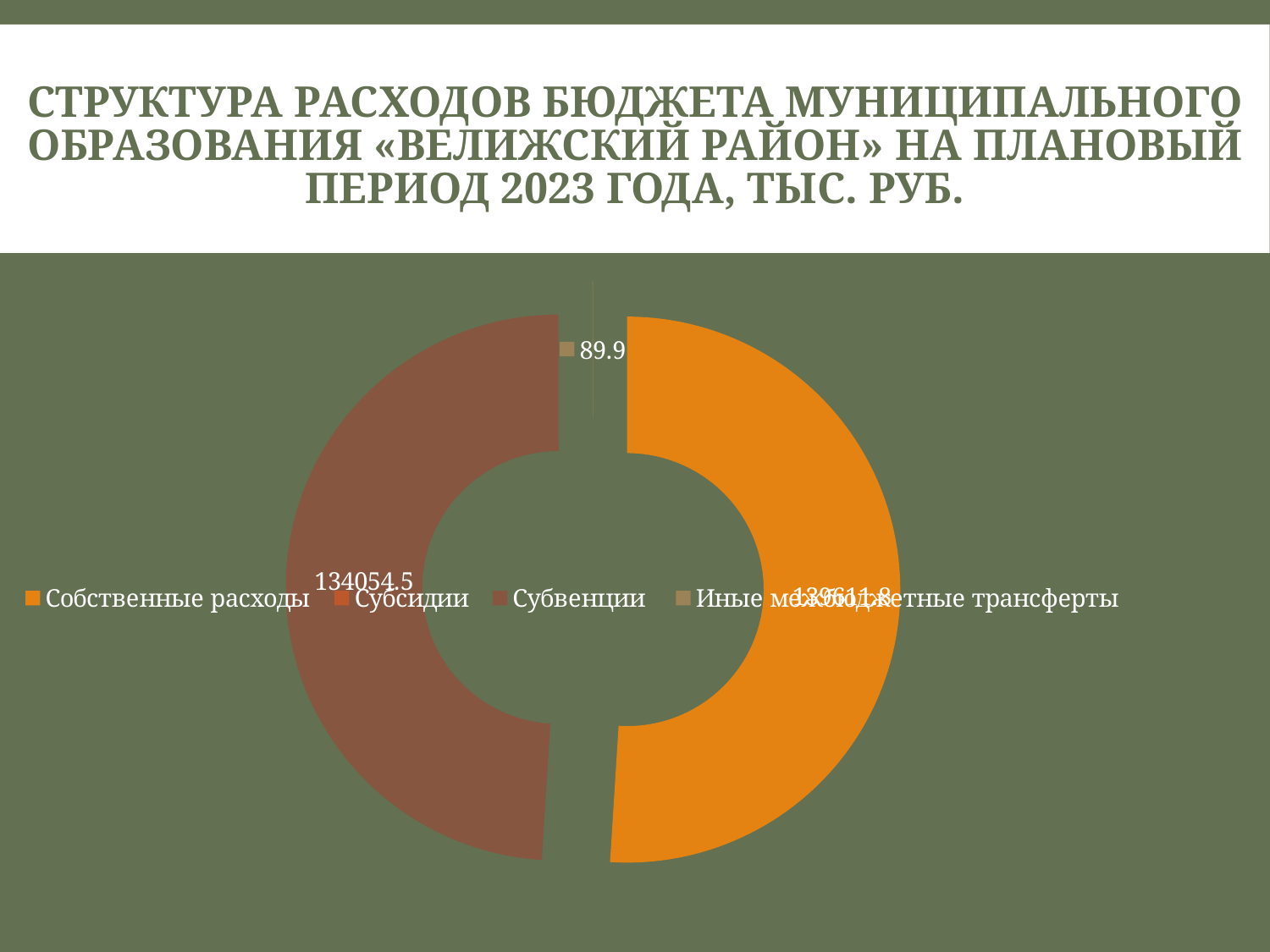
What is the value for Иные межбюджетные трансферты? 89.9 Which is larger, Собственные расходы or Иные межбюджетные трансферты? Собственные расходы Which is larger, Субвенции or Иные межбюджетные трансферты? Субвенции What is the value for Субвенции? 134054.5 What year does the slide title say the planned budget expenditure structure is for? 2023 What colour represents Собственные расходы in the chart? orange What kind of chart is shown on the slide? doughnut chart Which category is shown in brown? Субвенции Which category has the data label 89.9? Иные межбюджетные трансферты How many categories does the legend list? 4